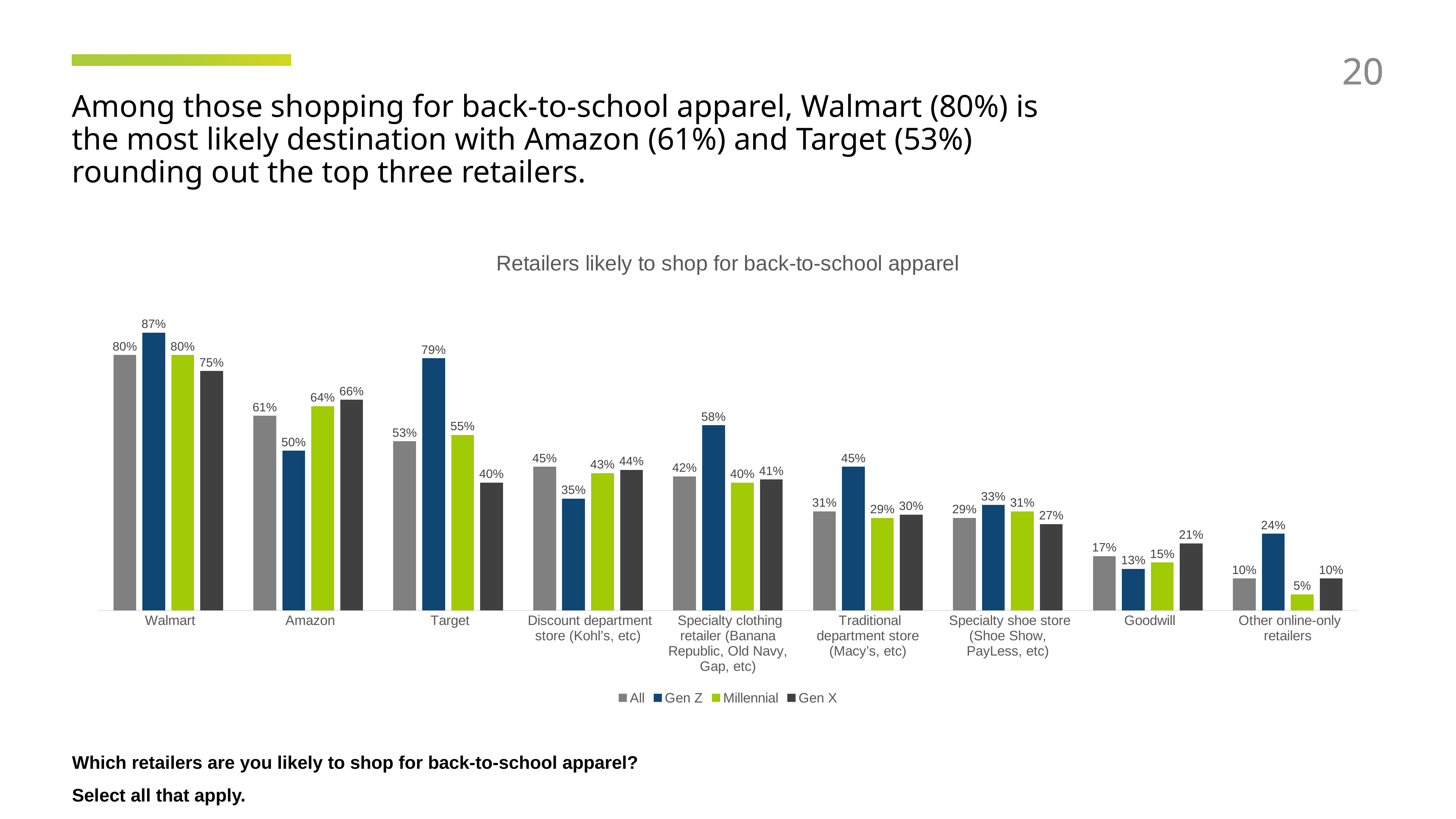
What is the Gen X value for Target? 40% Which retailer has the lowest Millennial value? Other online-only retailers What is the difference between the Gen Z and Gen X values for Target? 39% Which retailer has the highest All value? Walmart How many series does the legend list? 4 What kind of chart is shown? Bar chart What is the All value for Goodwill? 17% What is the Millennial value for Amazon? 64% Which is larger for Amazon: the Gen Z value or the Gen X value? Gen X What is the title of the chart? Retailers likely to shop for back-to-school apparel How many retailer categories are shown on the x axis? 9 What is the Gen Z value for Walmart? 87%